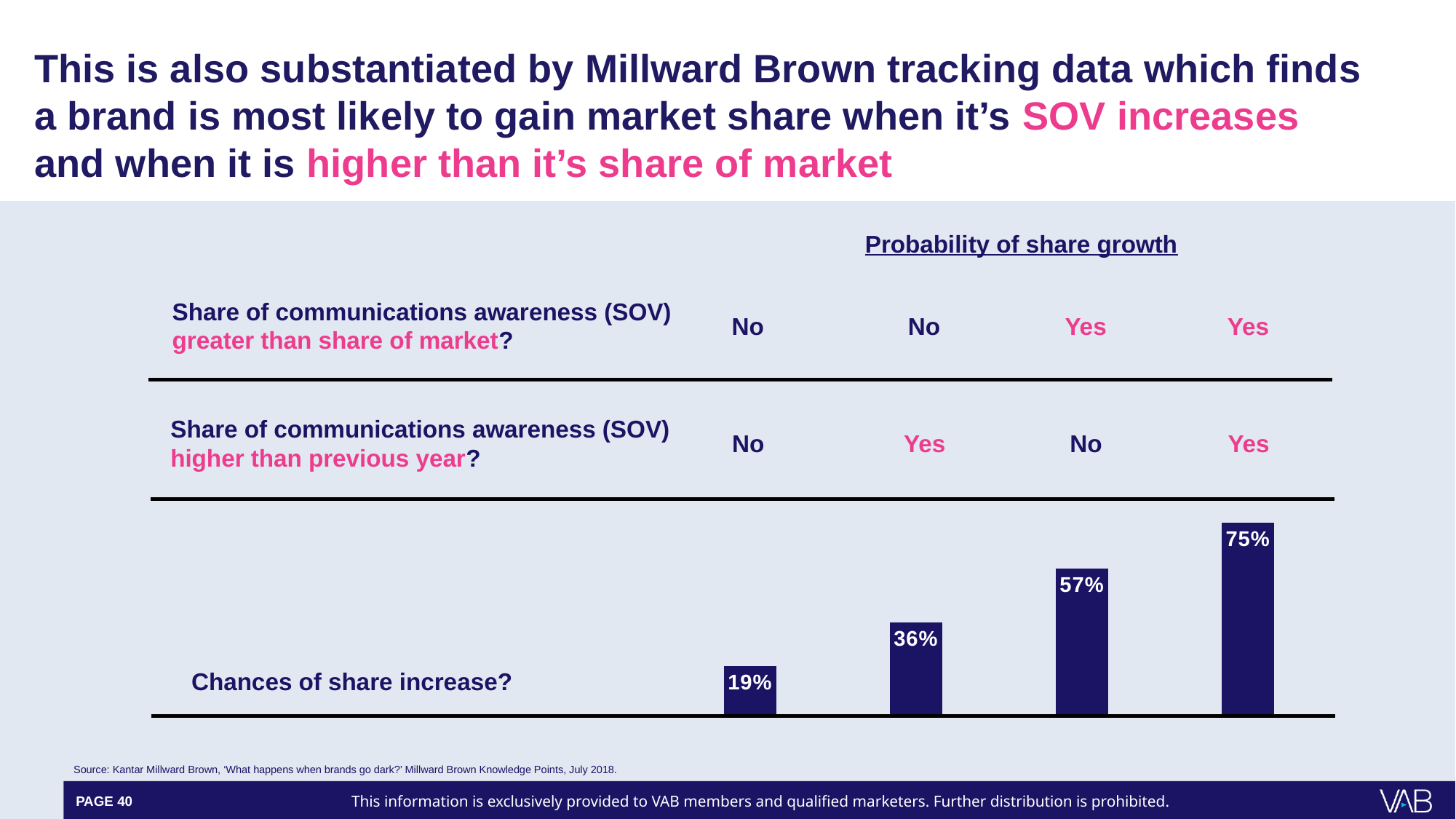
What is the chance of share increase when SOV is greater than share of market and higher than the previous year? 75% Which has a higher chance of share increase: SOV greater than share of market but not higher than previous year, or SOV higher than previous year but not greater than share of market? SOV greater than share of market but not higher than previous year (57%) Do the chances of share increase rise or fall from left to right across the bars? Rise What is the heading above the chart columns? Probability of share growth What is the chance of share increase when SOV is not greater than share of market and not higher than the previous year? 19% What is the chance of share increase when SOV is not greater than share of market but is higher than the previous year? 36% What is the difference in chance of share increase between the Yes/Yes scenario and the No/No scenario? 56 percentage points How many bars are shown in the chart? 4 Which scenario has the lowest chance of share increase? SOV not greater than share of market and not higher than previous year (No/No) Which scenario has the highest chance of share increase? SOV greater than share of market and higher than previous year (Yes/Yes) What type of chart is used to show the chances of share increase? Bar chart What is the chance of share increase when SOV is greater than share of market but not higher than the previous year? 57%